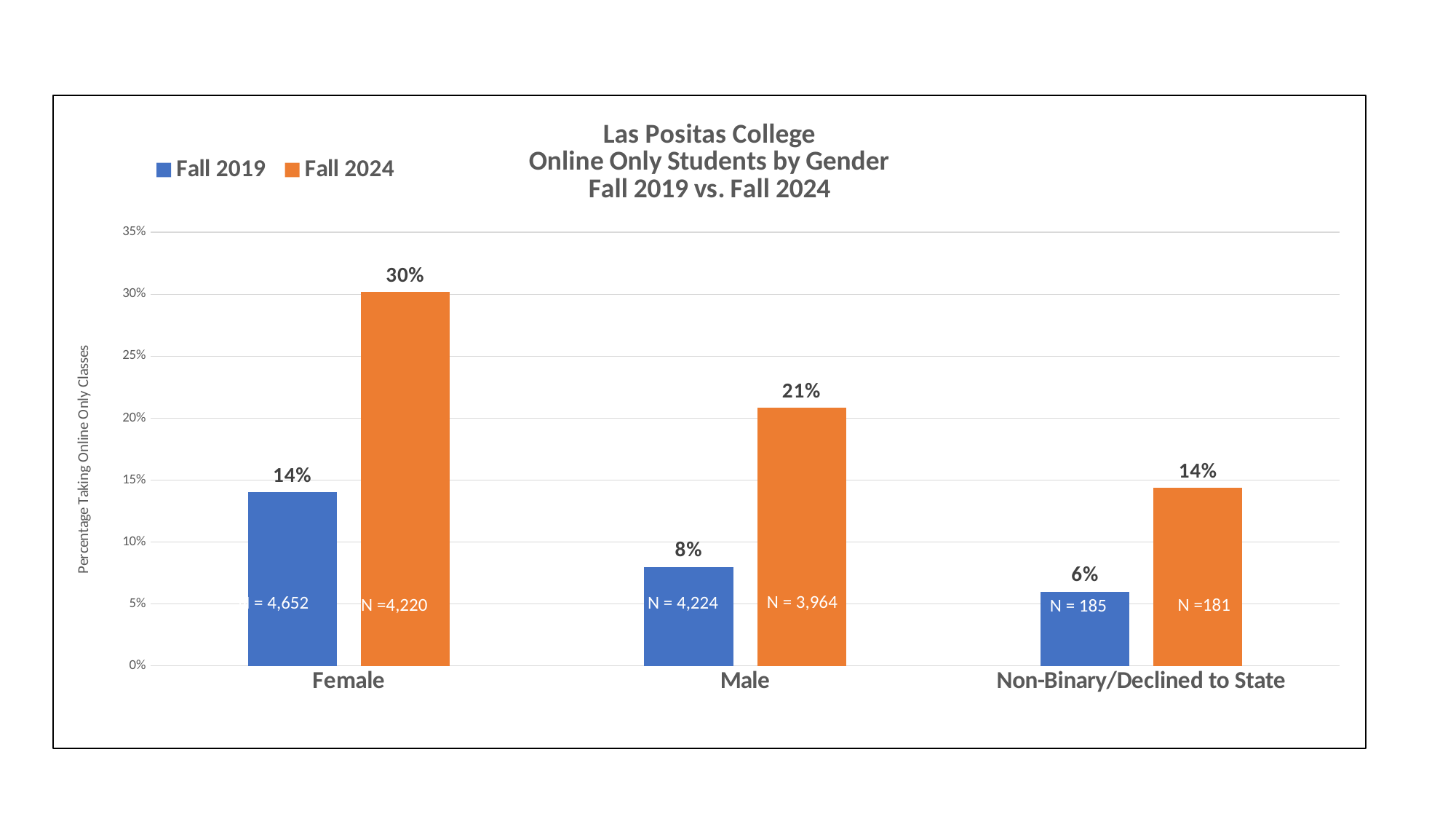
How many gender categories are shown on the x axis? 3 What kind of chart is shown on the slide? Bar chart What is the difference between the Fall 2024 and Fall 2019 values for Female students? 16% Which gender category has the lowest Fall 2019 value? Non-Binary/Declined to State How many series does the legend list? 2 What is the N value shown inside the Fall 2019 bar for Male students? N = 4,224 Which gender category has the highest Fall 2024 value? Female What percentage of Male students were online only in Fall 2019? 8% What is the Fall 2019 value for Non-Binary/Declined to State? 6% What percentage of Female students were online only in Fall 2024? 30% What is the difference between the Fall 2024 and Fall 2019 values for Male students? 13% Which is larger: the Fall 2024 value for Male or the Fall 2024 value for Non-Binary/Declined to State? Male